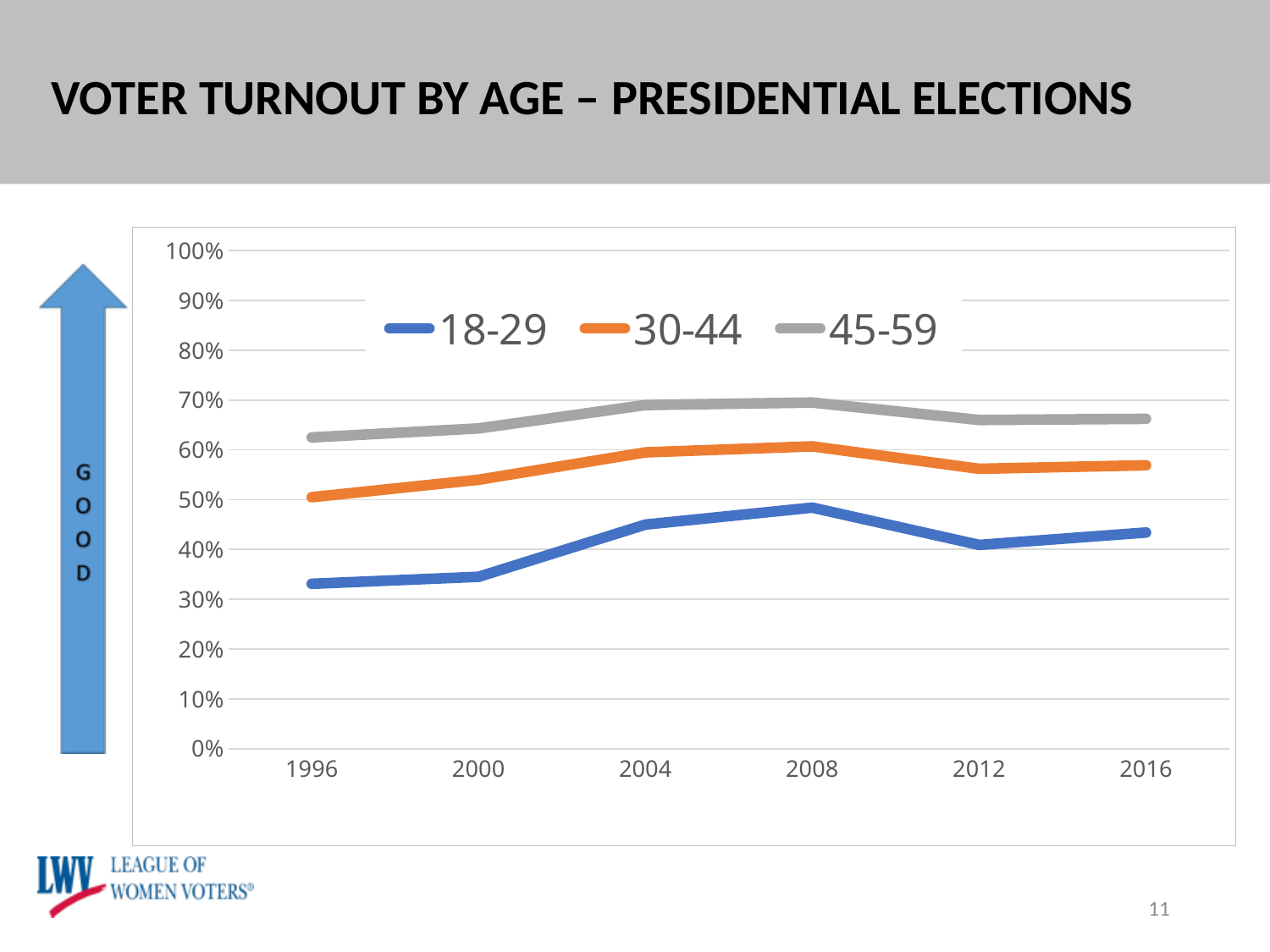
Which colour is used for the 30-44 series? orange How many election years are plotted along the x axis? 6 Is the turnout for the 30-44 group in 2004 greater or less than 50%? greater Is the turnout for the 45-59 group in 2008 greater or less than 60%? greater Which age group has the highest turnout in 2016? 45-59 For the 18-29 group, is turnout higher in 2004 or in 2012? 2004 In which year is turnout for the 45-59 group at its lowest? 1996 In which year is turnout for the 18-29 group at its highest? 2008 Is the turnout for the 18-29 group in 1996 greater or less than 40%? less How many series does the legend list? 3 What kind of chart is shown on the slide? line chart Does turnout for the 18-29 group rise or fall from 1996 to 2008? rise